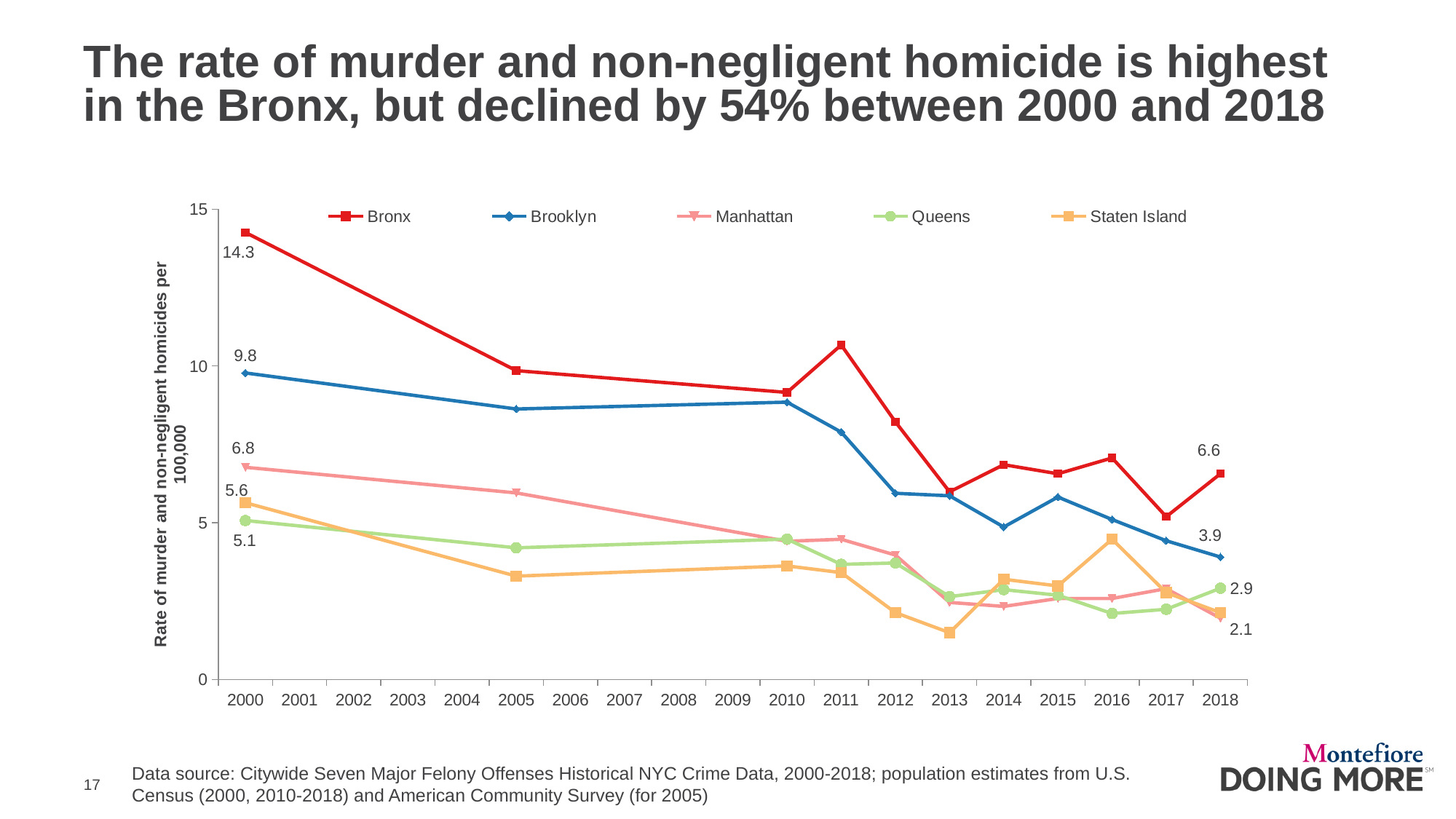
Which borough had the highest rate in 2000? Bronx In 2000, which had the higher rate, Manhattan or Staten Island? Manhattan What was the rate for Queens in 2018? 2.9 What was Brooklyn's rate in 2018? 3.9 Is the Bronx value for 2011 greater or less than 10? greater How many boroughs (series) does the legend list? 5 By how much did the Bronx rate fall between 2000 and 2018? 7.7 What was the Bronx rate in 2018? 6.6 What kind of chart is shown on the slide? Line chart What was Brooklyn's rate in 2000? 9.8 What was the Bronx rate of murder and non-negligent homicide per 100,000 in 2000? 14.3 Which borough had the lowest rate in 2000? Queens